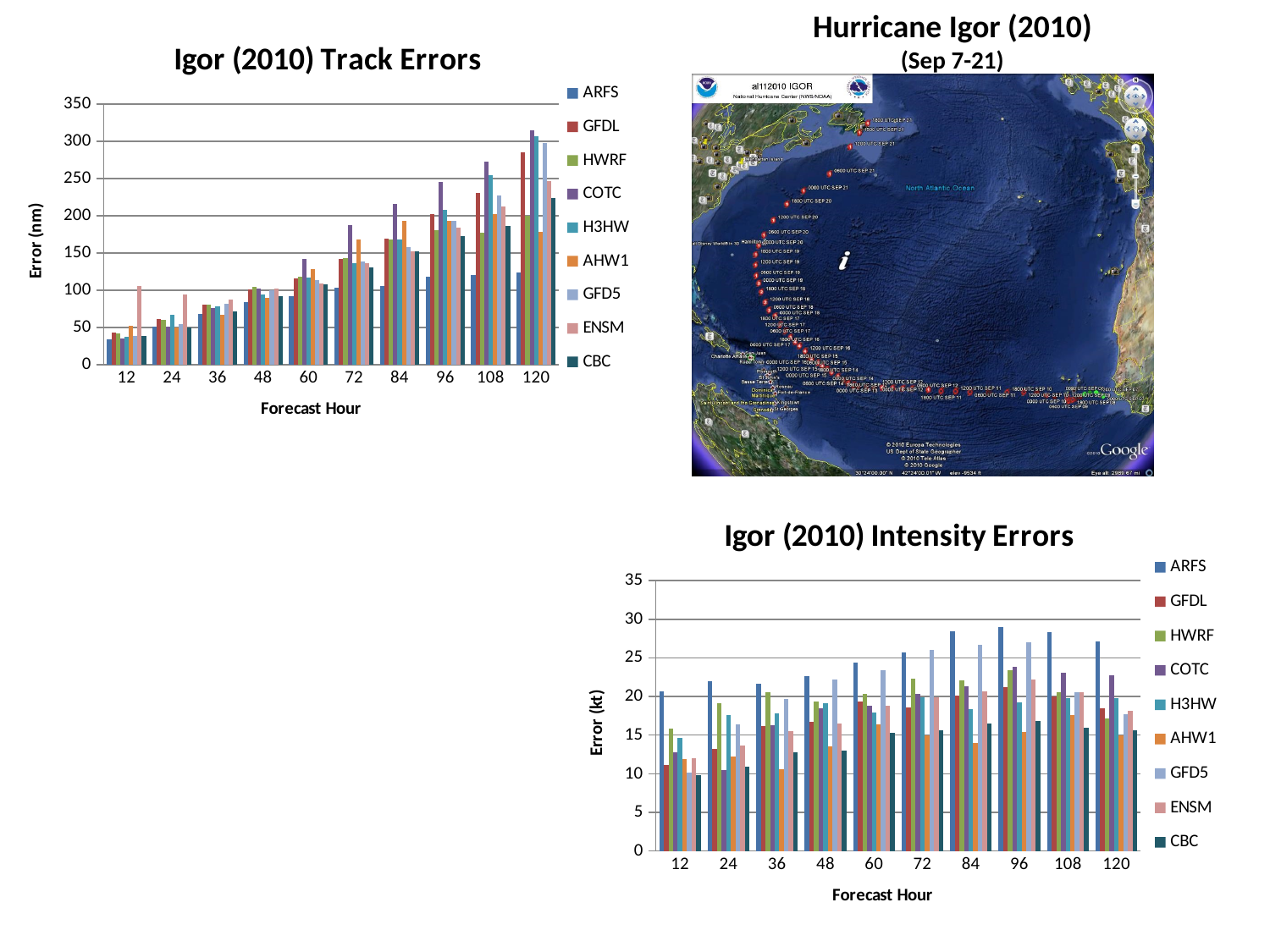
In the "Igor (2010) Track Errors" chart, is the value for ARFS at forecast hour 12 greater or less than 50? less In the "Igor (2010) Track Errors" chart, which series has the lowest error at forecast hour 120? ARFS In the "Igor (2010) Intensity Errors" chart, which series has the highest error at forecast hour 96? ARFS What kind of chart is the "Igor (2010) Track Errors" chart? bar chart How many series does the legend of the "Igor (2010) Intensity Errors" chart list? 9 What is the y-axis label of the "Igor (2010) Intensity Errors" chart? Error (kt) In the "Igor (2010) Intensity Errors" chart, is the value for ARFS at forecast hour 96 greater or less than 25? greater How many forecast hour categories are shown on the x axis of the "Igor (2010) Track Errors" chart? 10 In the "Igor (2010) Track Errors" chart, at forecast hour 120, which is larger: GFDL or HWRF? GFDL In the "Igor (2010) Track Errors" chart, is the value for COTC at forecast hour 120 greater or less than 300? greater In the "Igor (2010) Track Errors" chart, do the COTC errors generally rise or fall as the forecast hour increases? rise